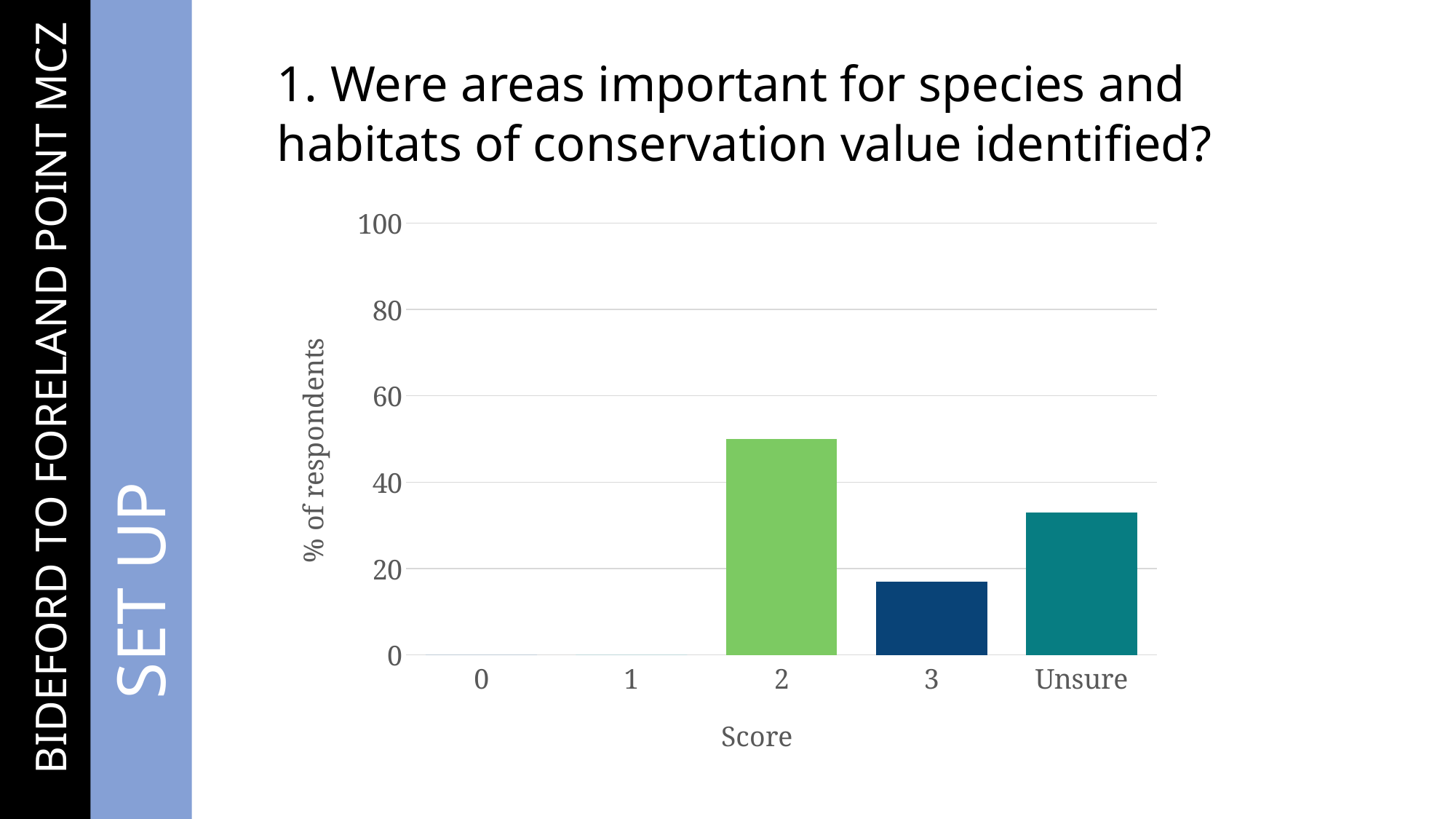
Is the value for Unsure greater or less than 20? greater Which is larger, the value for score 3 or the value for Unsure? Unsure Is the value for score 2 greater or less than 40? greater Is the value for Unsure greater or less than 40? less What is the percentage of respondents for score 0? 0 What is the label of the vertical axis? % of respondents Which score category has the highest percentage of respondents? 2 What kind of chart is shown on the slide? bar chart How many score categories are shown on the x axis? 5 What is the label of the horizontal axis? Score Which is larger, the value for score 2 or the value for Unsure? score 2